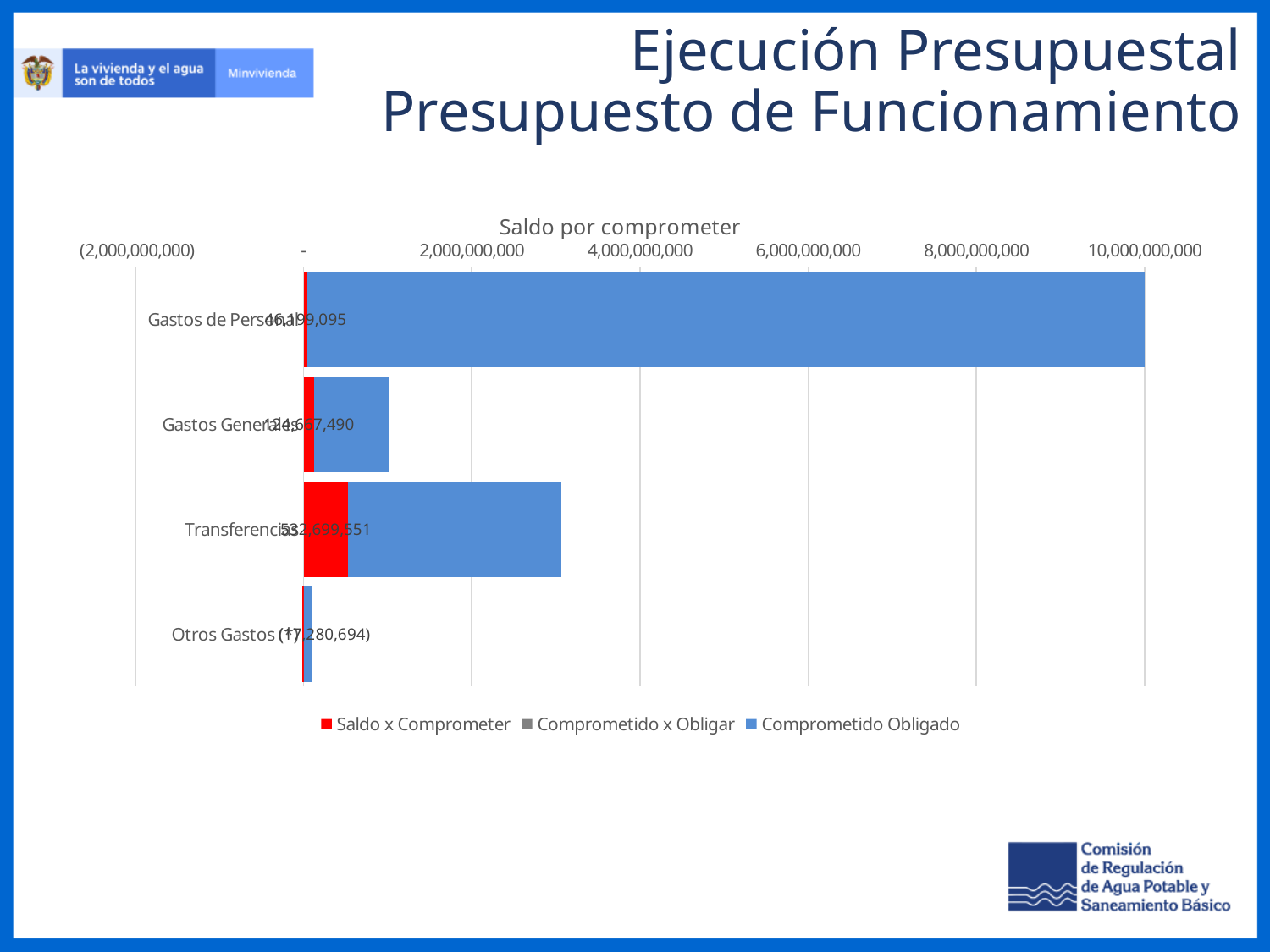
How many categories are plotted on the chart? 4 Which series is shown in red in the legend? Saldo x Comprometer Is the Comprometido Obligado value for Gastos de Personal greater or less than 8,000,000,000? greater What is the title of the chart? Saldo por comprometer Is the Comprometido Obligado value for Transferencias greater or less than 4,000,000,000? less Is the Comprometido Obligado value for Gastos Generales greater or less than 2,000,000,000? less How many series does the legend list? 3 Which category has the smallest Comprometido Obligado bar? Otros Gastos (*) Which has the larger Comprometido Obligado bar, Transferencias or Gastos Generales? Transferencias Which category has the largest Comprometido Obligado bar? Gastos de Personal What is the data label shown for Transferencias? 532,699,551 What kind of chart is shown on the slide? bar chart